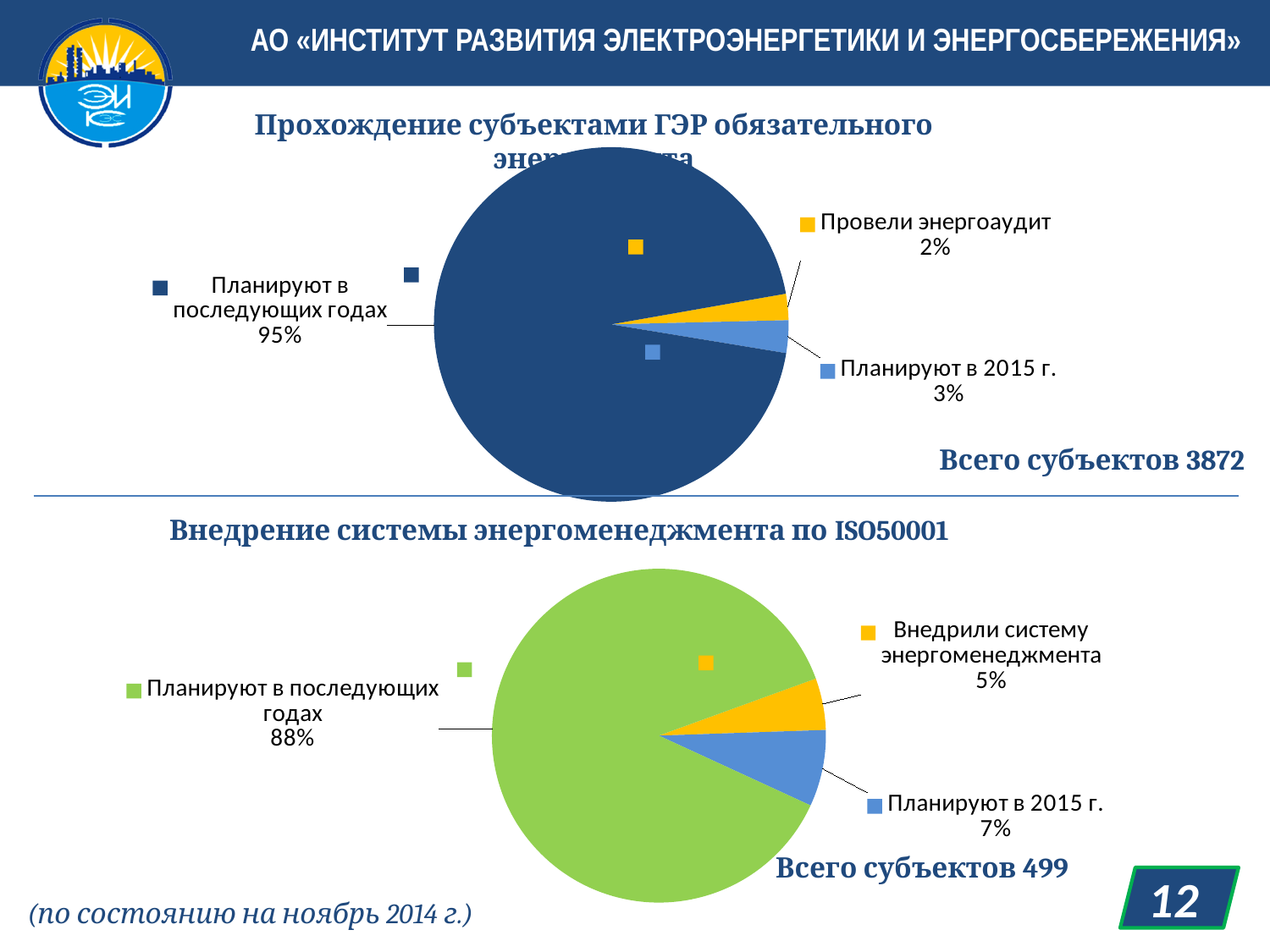
In the top pie chart, what share of subjects plan an energy audit in subsequent years (Планируют в последующих годах)? 95% In the top pie chart, what share of subjects have already conducted an energy audit (Провели энергоаудит)? 2% What is the total number of subjects stated next to the bottom pie chart (Всего субъектов)? 499 In the bottom pie chart, which category has the largest share? Планируют в последующих годах In the bottom pie chart, what share of subjects plan implementation in 2015 (Планируют в 2015 г.)? 7% What type of chart is used for both charts on the slide? Pie chart In the bottom pie chart (Внедрение системы энергоменеджмента по ISO50001), what share of subjects have implemented an energy management system? 5% In the top pie chart, which category has the smallest share? Провели энергоаудит In the bottom pie chart, what is the difference in percentage points between 'Планируют в 2015 г.' and 'Внедрили систему энергоменеджмента'? 2 percentage points In the top pie chart, what share of subjects plan an energy audit in 2015 (Планируют в 2015 г.)? 3% In the top pie chart, how many slices does the pie have? 3 In the bottom pie chart, what share of subjects plan implementation in subsequent years (Планируют в последующих годах)? 88%